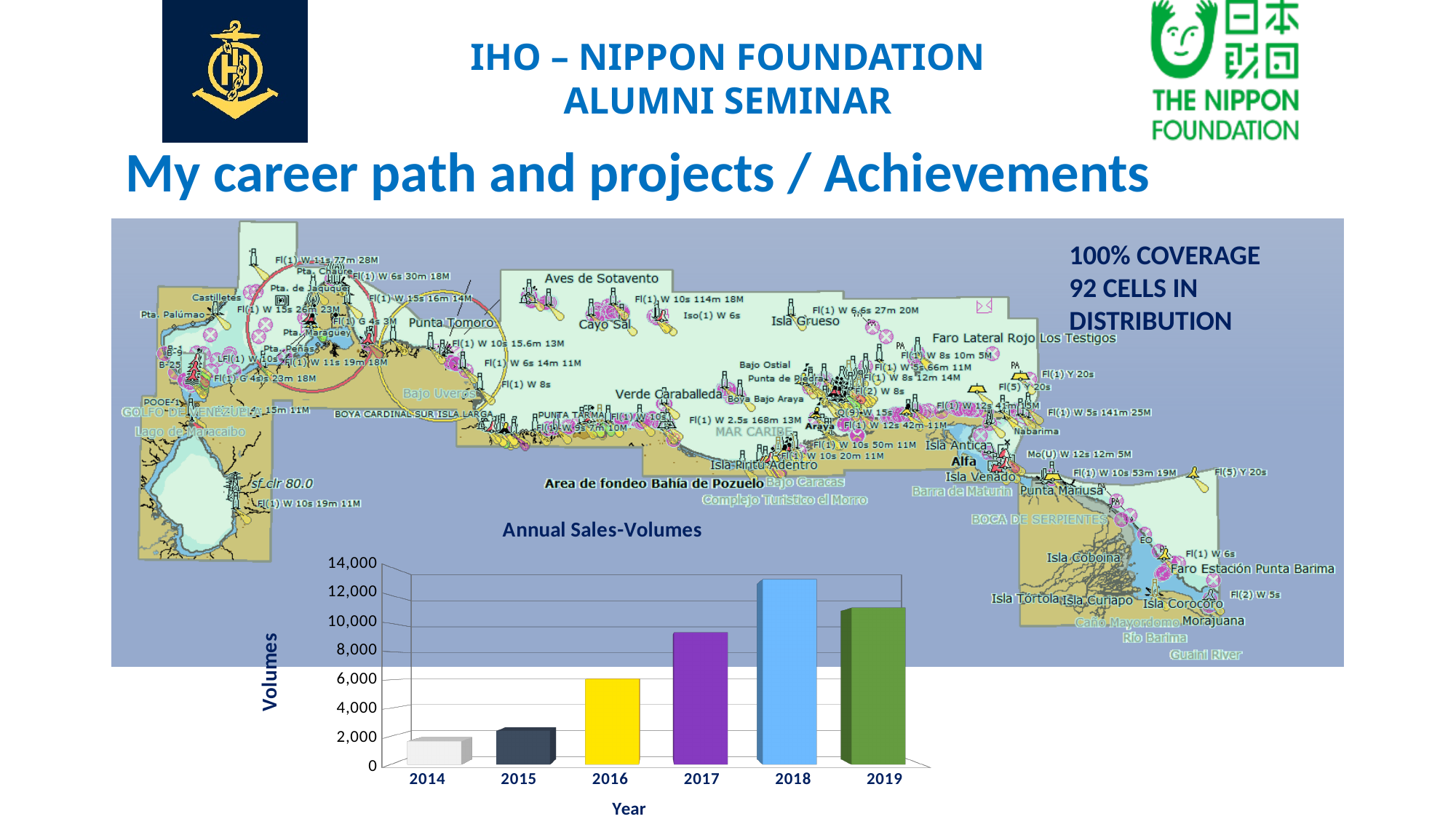
Is the value for 2017 greater or less than 8,000? greater Is the value for 2019 greater or less than 10,000? greater Which year has the highest sales volume? 2018 How do the sales volumes change from 2014 to 2018? They rise each year Which year has the lowest sales volume? 2014 Is the value for 2014 greater or less than 2,000? less Which year has the larger sales volume, 2018 or 2019? 2018 What is the title of the chart? Annual Sales-Volumes What type of chart is shown on the slide? Bar chart How many years are plotted in the Annual Sales-Volumes chart? 6 Which year has the larger sales volume, 2016 or 2017? 2017